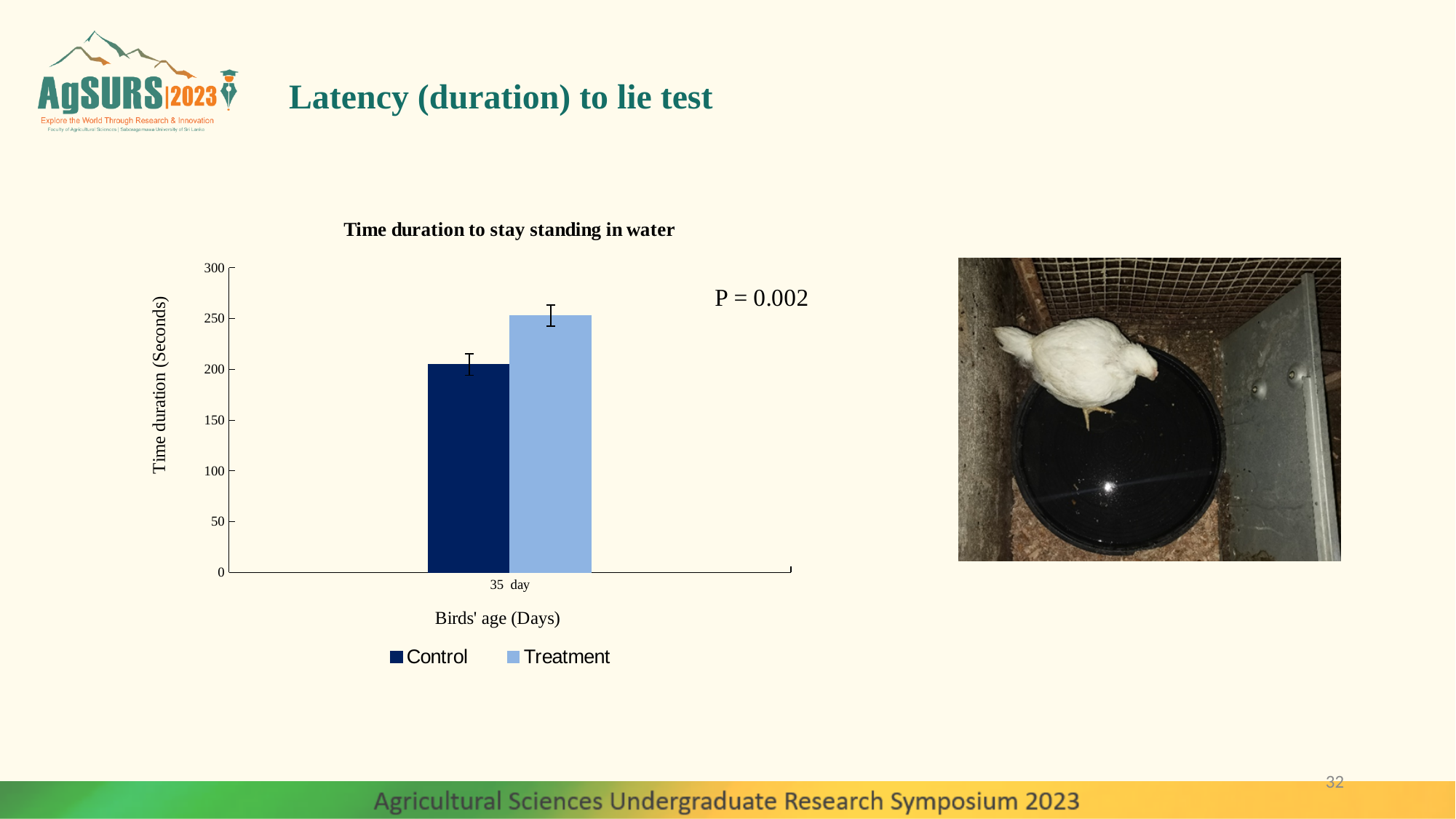
What is the title of the chart? Time duration to stay standing in water How many categories are shown on the x axis? 1 How many series does the chart legend list? 2 What is the category label on the x axis? 35 day Is the value for Control at 35 day greater or less than 150? greater Which series has the higher value at 35 day, Control or Treatment? Treatment What is the label of the y axis? Time duration (Seconds) Is the value for Control at 35 day greater or less than 250? less Is the value for Treatment at 35 day greater or less than 200? greater Which series has the lowest value in the chart? Control What type of chart is shown on the slide? bar chart